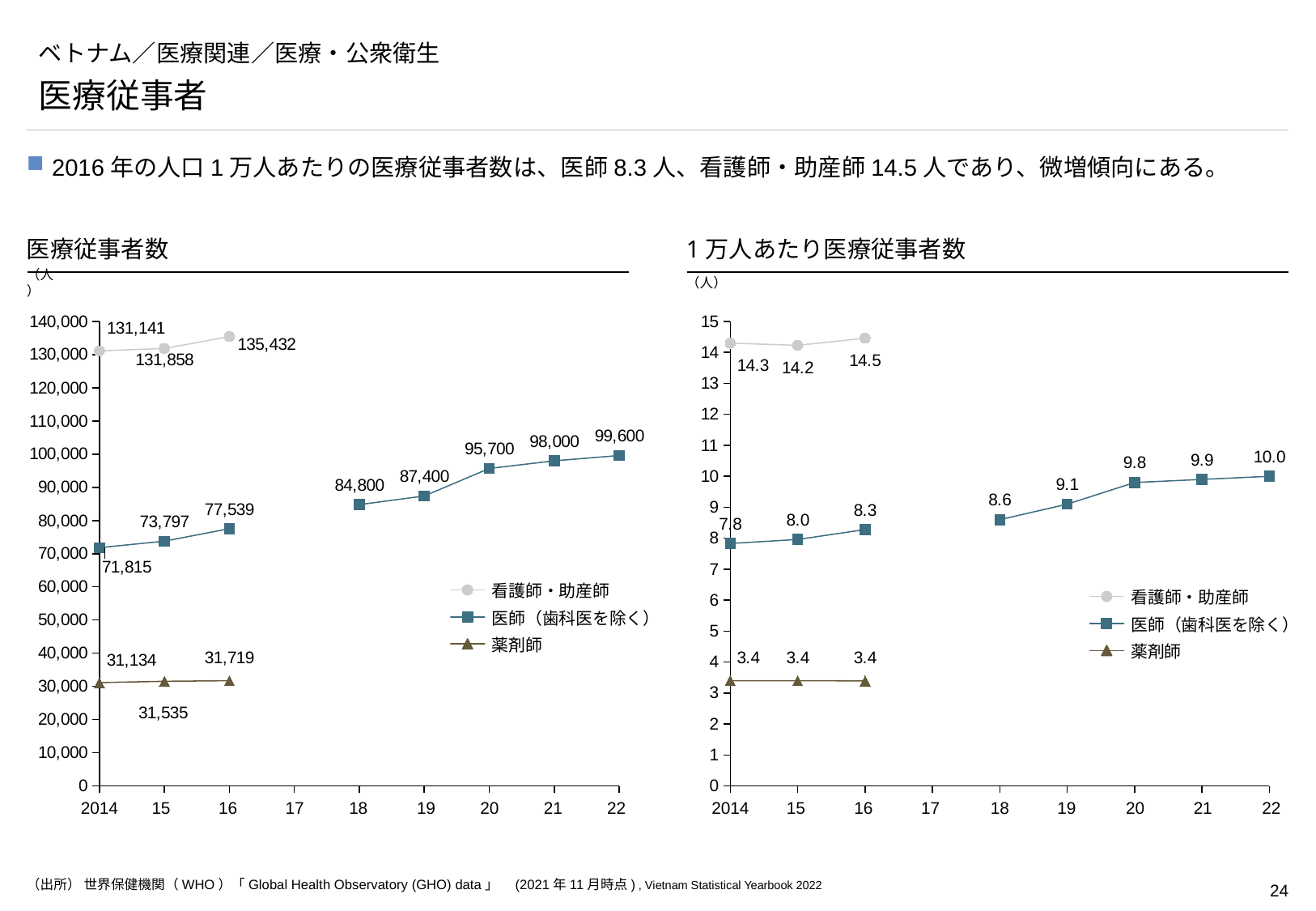
「医療従事者数」のグラフで、2015年の薬剤師の値はいくつですか。 31,535 「医療従事者数」のグラフで、2016年の看護師・助産師と医師（歯科医を除く）ではどちらが多いですか。 看護師・助産師 「医療従事者数」のグラフで、2016年の看護師・助産師の値はいくつですか。 135,432 「1万人あたり医療従事者数」のグラフで、2014年の看護師・助産師と薬剤師の差はいくつですか。 10.9 「医療従事者数」のグラフで、医師（歯科医を除く）の値は2018年から2022年にかけて増加していますか、減少していますか。 増加 「1万人あたり医療従事者数」のグラフで、2016年の医師（歯科医を除く）の値はいくつですか。 8.3 「医療従事者数」のグラフで、2022年の医師（歯科医を除く）の値はいくつですか。 99,600 「医療従事者数」のグラフはどの種類のグラフですか。 折れ線グラフ 「1万人あたり医療従事者数」のグラフで、2022年の医師（歯科医を除く）の値はいくつですか。 10.0 「1万人あたり医療従事者数」のグラフで、看護師・助産師の値が最も高い年はいつですか。 2016年 「医療従事者数」のグラフで、医師（歯科医を除く）の2014年から2016年の増加数はいくつですか。 5,724 「1万人あたり医療従事者数」のグラフの凡例には何系列ありますか。 3